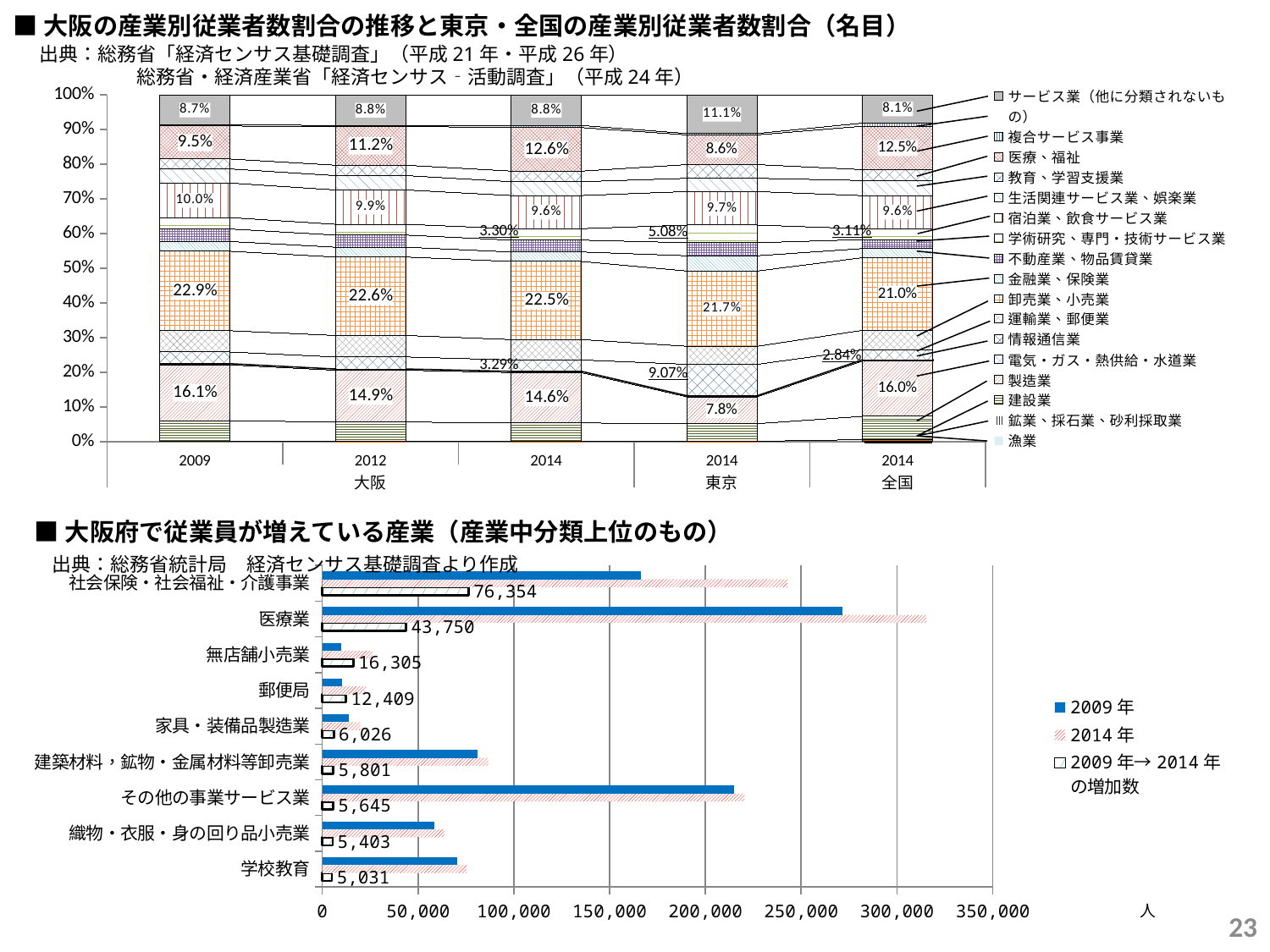
In the bottom chart, is the 2009年 value for 医療業 greater or less than 250,000? greater What kind of chart is the top chart? stacked bar chart In the top chart, what is the share of 卸売業、小売業 for 東京 in 2014? 21.7% In the top chart, does the 製造業 share for 大阪 rise or fall from 2009 to 2014? fall In the top chart, by how many percentage points did the 製造業 share for 大阪 change between 2009 (16.1%) and 2014 (14.6%)? 1.5 percentage points In the top chart, which has the larger 製造業 share in 2014, 東京 or 全国? 全国 In the top chart, what is the share of 製造業 for 大阪 in 2009? 16.1% In the top chart, what is the share of 医療、福祉 for 大阪 in 2014? 12.6% In the bottom chart, what is the 2009年→2014年 increase for 医療業? 43,750 In the bottom chart, which industry has the largest 2009年→2014年 increase? 社会保険・社会福祉・介護事業 In the bottom chart, which industry has the smallest 2009年→2014年 increase? 学校教育 How many industries are listed in the bottom chart? 9